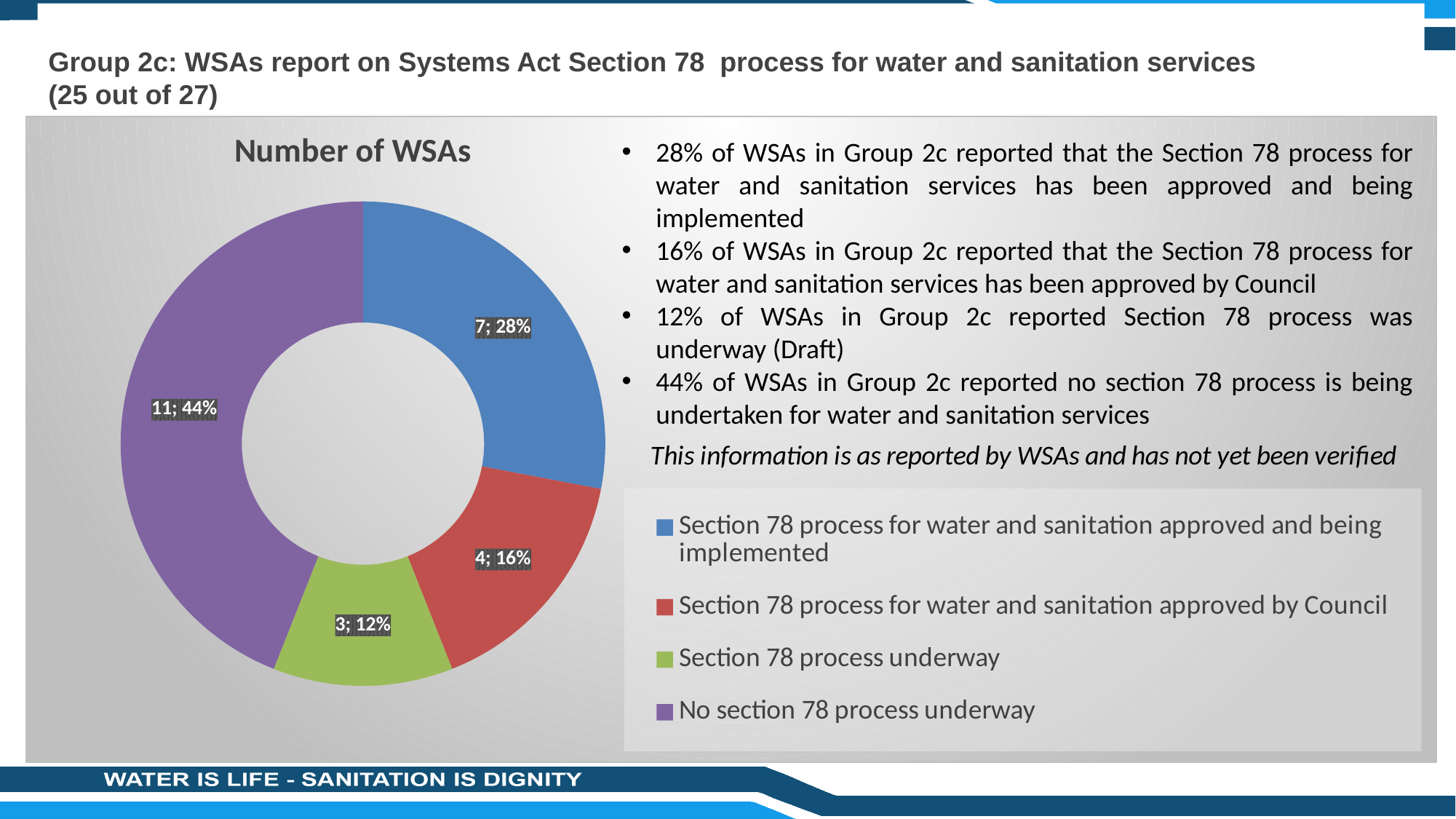
Which is larger: the number of WSAs with the process approved by Council or the number with the process underway? Section 78 process for water and sanitation approved by Council How many WSAs reported no section 78 process underway? 11 Which category has the smallest slice? Section 78 process underway How many categories does the chart show? 4 What colour is the 'No section 78 process underway' slice? Purple What kind of chart is shown on the slide? Doughnut (pie) chart What is the difference in the number of WSAs between 'No section 78 process underway' and 'Section 78 process for water and sanitation approved and being implemented'? 4 What is the title of the chart? Number of WSAs Which category has the largest slice? No section 78 process underway How many WSAs reported the Section 78 process for water and sanitation approved by Council? 4 What share of the chart is the 'Section 78 process underway' slice? 12% How many WSAs reported the Section 78 process for water and sanitation approved and being implemented? 7